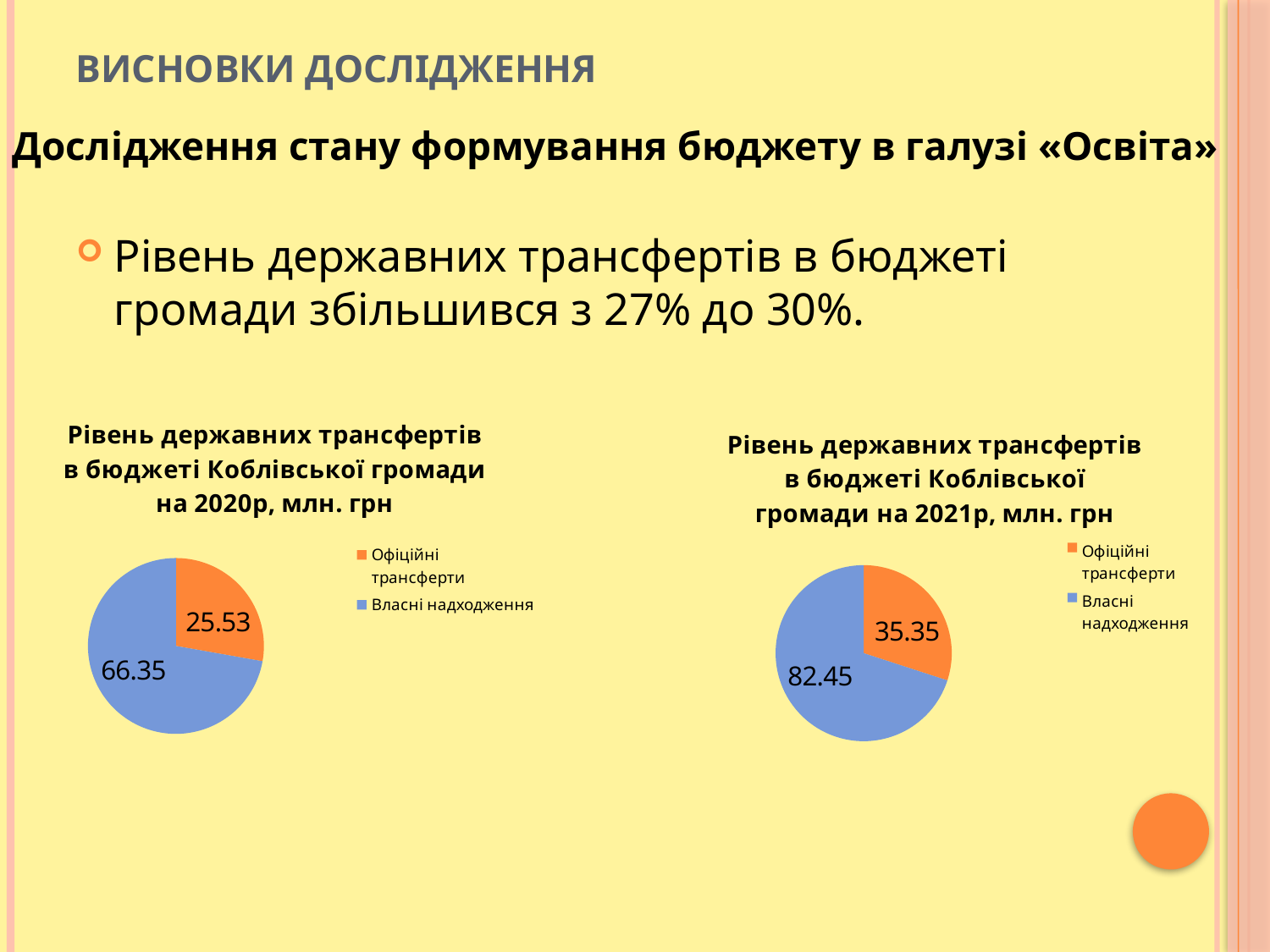
In the 2020 chart (left), what is the difference between Власні надходження and Офіційні трансферти? 40.82 How many entries does the legend of the 2020 chart (left) list? 2 In the 2021 chart (right), which category has the smallest slice? Офіційні трансферти In the 2020 chart (left), which category has the largest slice? Власні надходження In the 2021 chart (right), what is the total of the two slices? 117.8 In the 2021 chart (right), what is the value for Офіційні трансферти? 35.35 Which is larger: Офіційні трансферти in the 2020 chart or Офіційні трансферти in the 2021 chart? 2021 chart (35.35) How many slices does the 2021 chart (right) have? 2 In the 2020 chart (left), what is the value for Власні надходження? 66.35 What type of chart is used on the left of the slide (2020)? pie chart In the 2020 chart (left), what is the value for Офіційні трансферти? 25.53 In the 2021 chart (right), what is the value for Власні надходження? 82.45